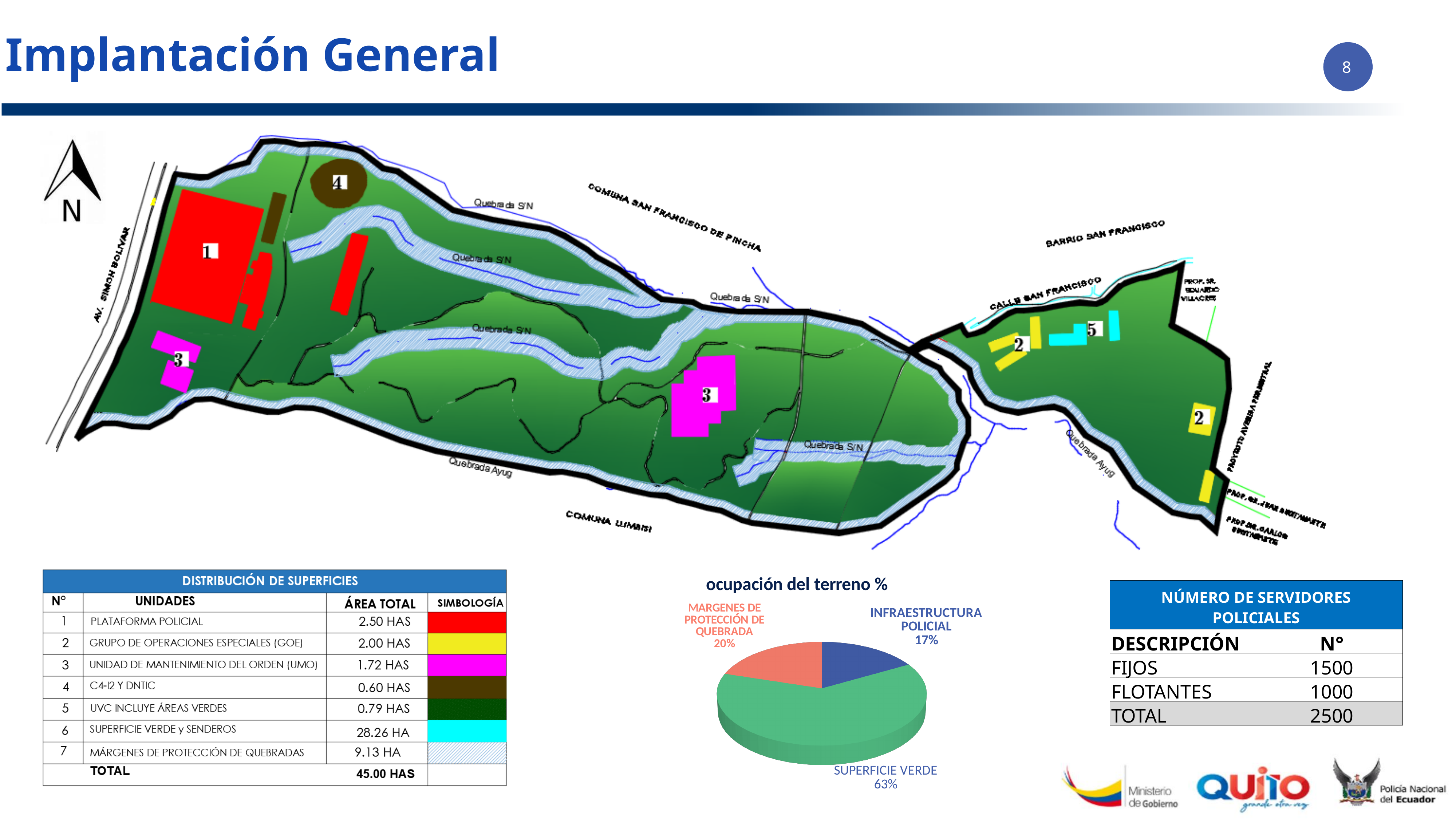
In the "ocupación del terreno %" chart, what colour is the SUPERFICIE VERDE slice? green How many slices does the "ocupación del terreno %" pie chart have? 3 What is the title of the pie chart on the slide? ocupación del terreno % Which slice of the "ocupación del terreno %" chart is the largest? SUPERFICIE VERDE In the "ocupación del terreno %" chart, what share does SUPERFICIE VERDE have? 63% In the "ocupación del terreno %" chart, what share does MARGENES DE PROTECCIÓN DE QUEBRADA have? 20% In the "ocupación del terreno %" chart, which is larger: MARGENES DE PROTECCIÓN DE QUEBRADA or INFRAESTRUCTURA POLICIAL? MARGENES DE PROTECCIÓN DE QUEBRADA In the "ocupación del terreno %" chart, what is the difference in percentage points between SUPERFICIE VERDE and MARGENES DE PROTECCIÓN DE QUEBRADA? 43 In the "ocupación del terreno %" chart, what share does INFRAESTRUCTURA POLICIAL have? 17% Which slice of the "ocupación del terreno %" chart is the smallest? INFRAESTRUCTURA POLICIAL What kind of chart is the "ocupación del terreno %" chart? pie chart In the "ocupación del terreno %" chart, what is the difference in percentage points between MARGENES DE PROTECCIÓN DE QUEBRADA and INFRAESTRUCTURA POLICIAL? 3